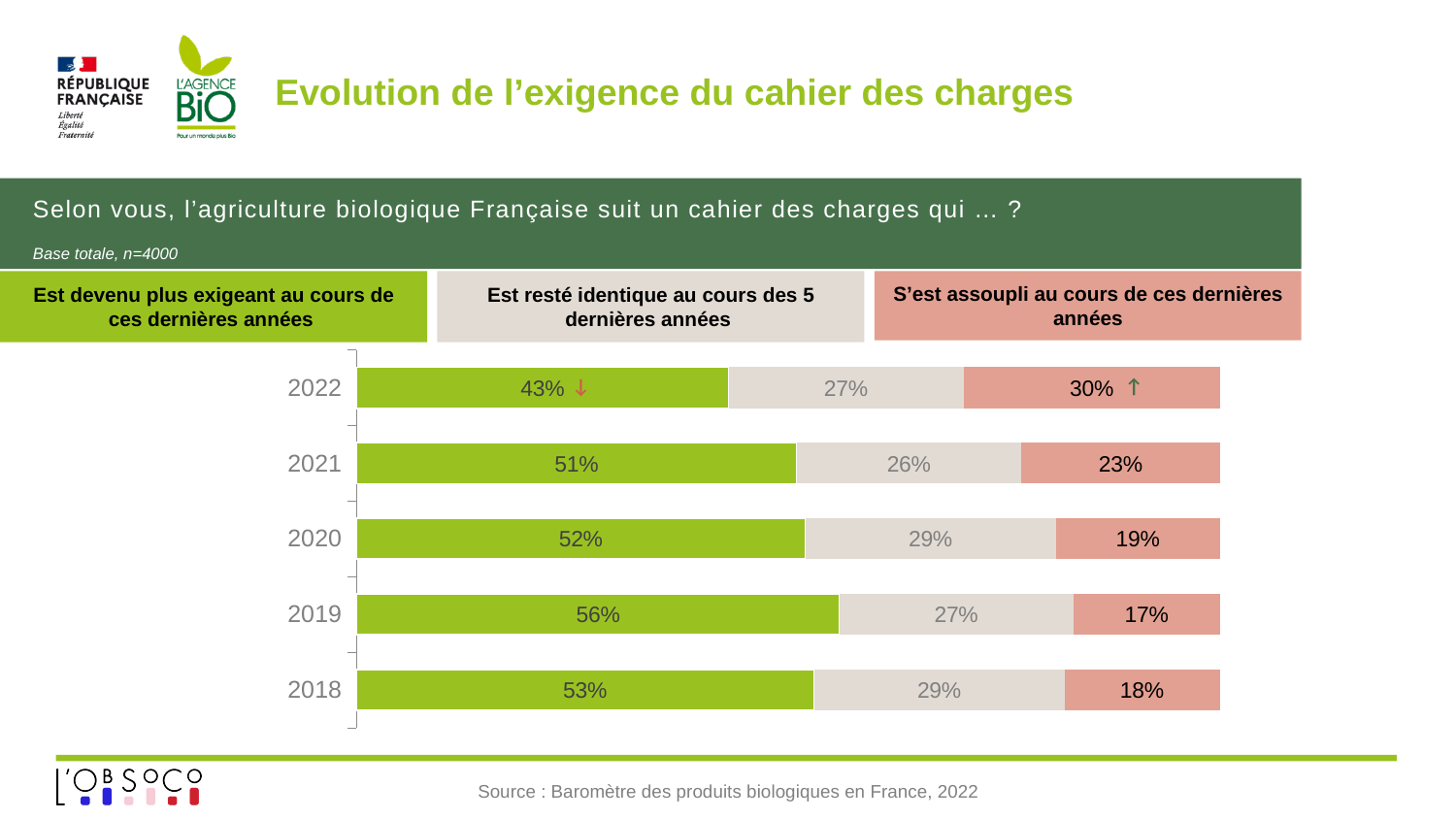
What percentage of respondents in 2019 said the specifications stayed the same ("Est resté identique")? 27% Which is larger: the "Est devenu plus exigeant" share in 2021 or in 2022? 2021 How many years are shown in the chart? 5 What percentage of respondents in 2018 said the specifications have been relaxed ("S'est assoupli")? 18% How many series (response categories) does the chart show? 3 What is the difference between the "S'est assoupli" share in 2022 and in 2021? 7 percentage points What percentage of respondents in 2022 said the specifications have become more demanding ("Est devenu plus exigeant")? 43% In which year was the share for "Est devenu plus exigeant" the highest? 2019 In which year was the share for "S'est assoupli" the lowest? 2019 What is the total of the three segments for 2020? 100% What type of chart is shown on the slide? Stacked bar chart From 2018 to 2022, does the "S'est assoupli" share generally rise or fall? Rise